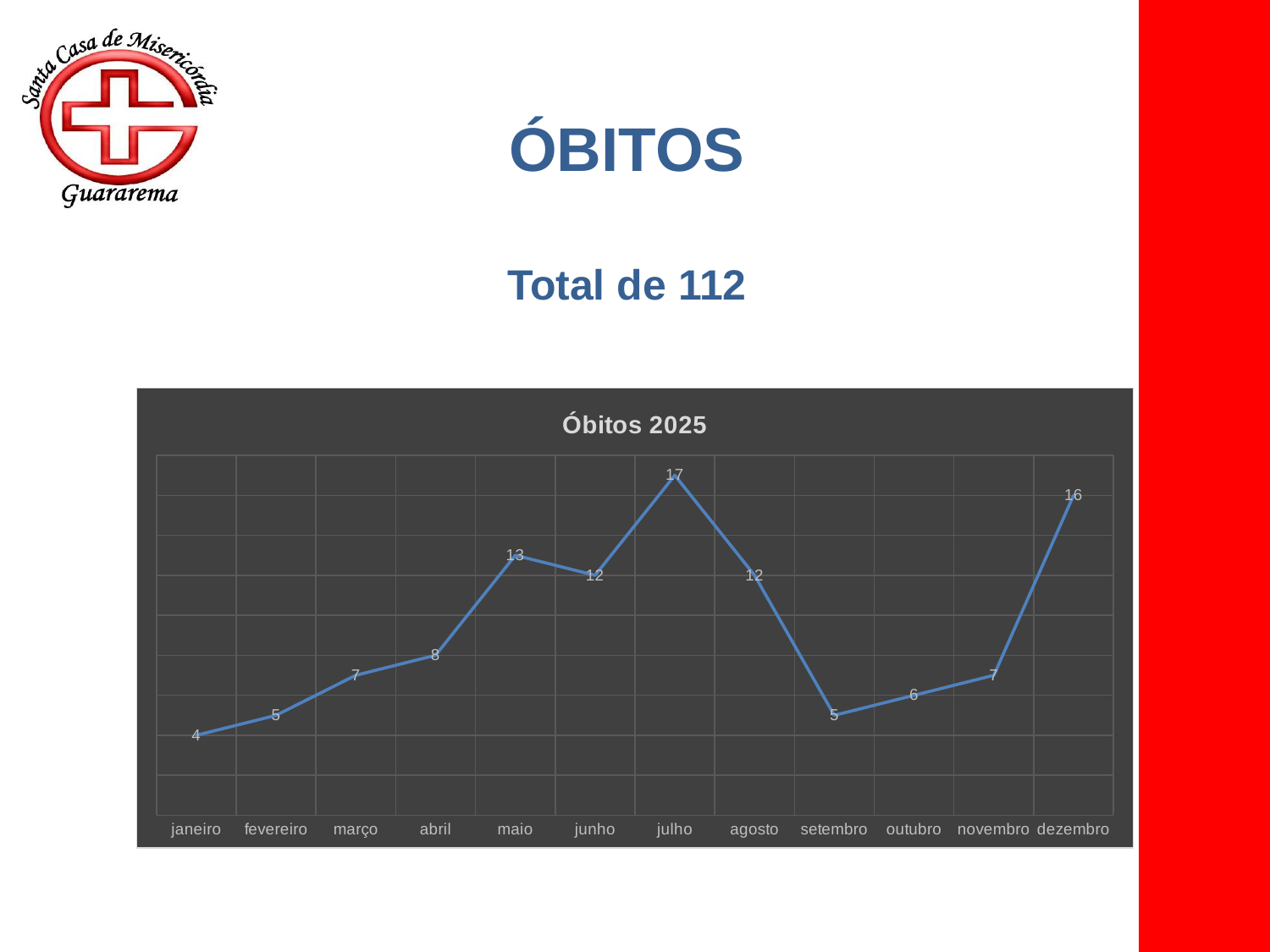
Which month has the highest value? julho What is the title of the chart? Óbitos 2025 What type of chart is shown on the slide? line chart Which is larger, the value for maio or the value for junho? maio Do the values rise or fall from janeiro to abril? rise What is the value for janeiro? 4 What is the value for setembro? 5 Which month has the lowest value? janeiro What is the difference between the values for julho and agosto? 5 How many months are plotted on the x axis? 12 What is the value for dezembro? 16 What is the value for julho? 17